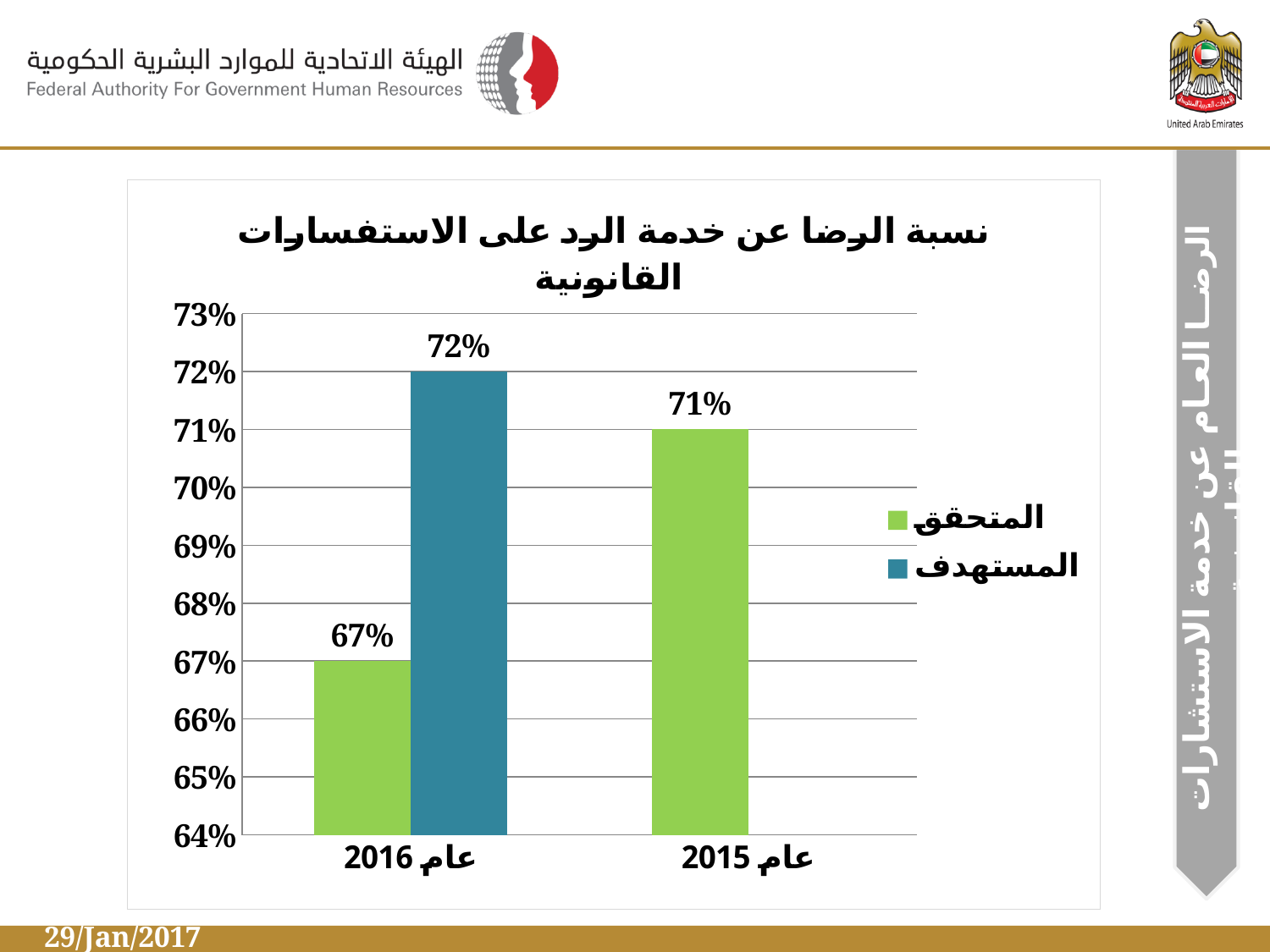
What is the difference between the target and the achieved value for عام 2016? 5% Which bar shows the highest value on the chart? المستهدف for عام 2016 (72%) Which bar shows the lowest value on the chart? المتحقق for عام 2016 (67%) What is the achieved (المتحقق) value for عام 2015? 71% How many year categories are shown on the x axis? 2 Which is larger: the achieved value for عام 2015 or the achieved value for عام 2016? عام 2015 What kind of chart is shown on the slide? Bar chart What is the achieved (المتحقق) value for عام 2016? 67% What is the target (المستهدف) value for عام 2016? 72% Which colour represents the المستهدف series in the legend? Blue By how much did the achieved (المتحقق) value change from عام 2015 to عام 2016? It fell by 4% How many series does the legend list? 2